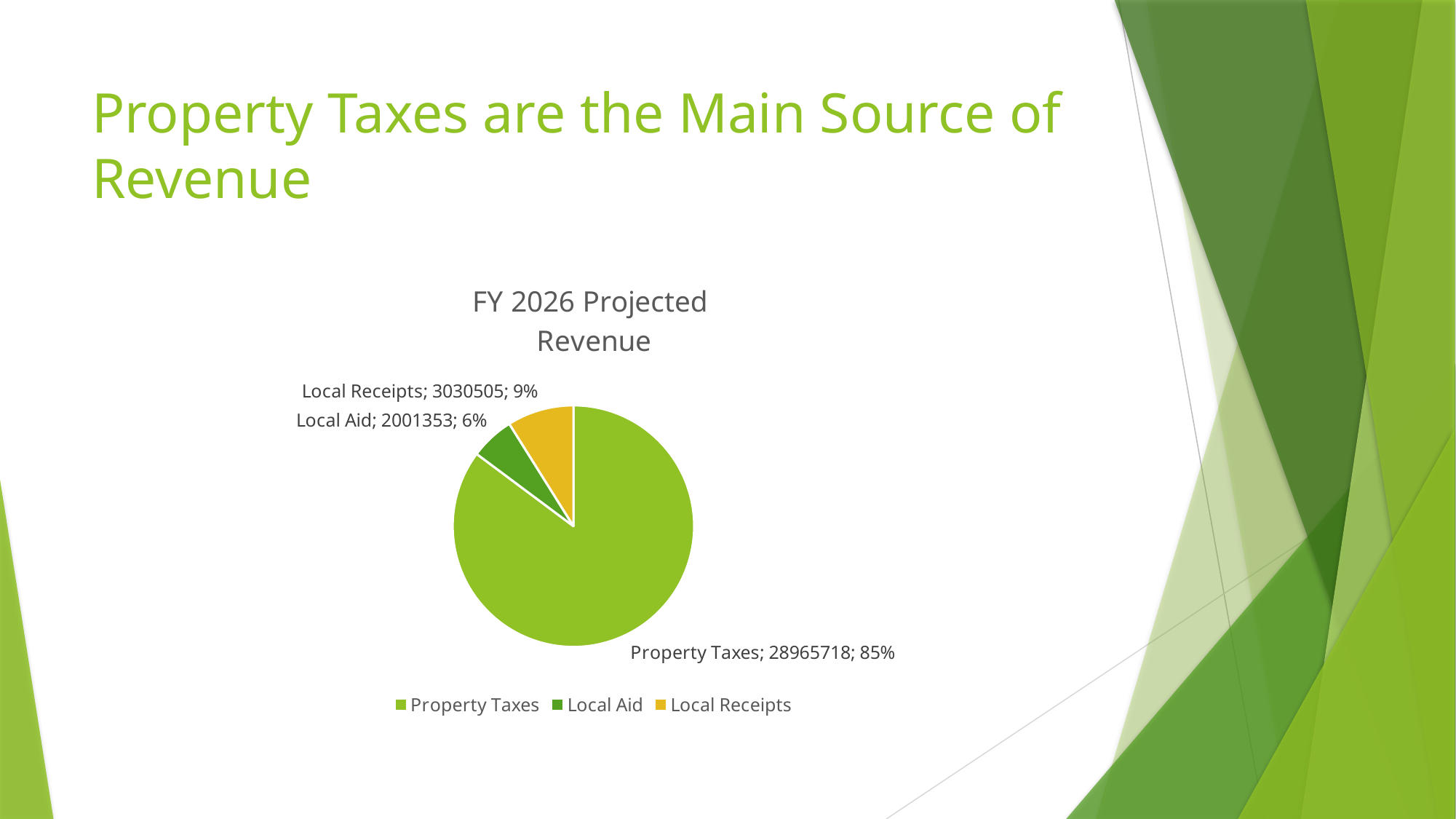
What is the title of the chart? FY 2026 Projected Revenue What is the value for Property Taxes? 28965718 What is the value for Local Aid? 2001353 What type of chart is shown on the slide? pie chart How many categories does the legend list? 3 Which category has the largest slice? Property Taxes What is the difference between the values for Local Receipts and Local Aid? 1029152 Which is larger, Local Receipts or Local Aid? Local Receipts What is the value for Local Receipts? 3030505 What share of the pie does Property Taxes represent? 85% Which category has the smallest slice? Local Aid What share of the pie does Local Receipts represent? 9%